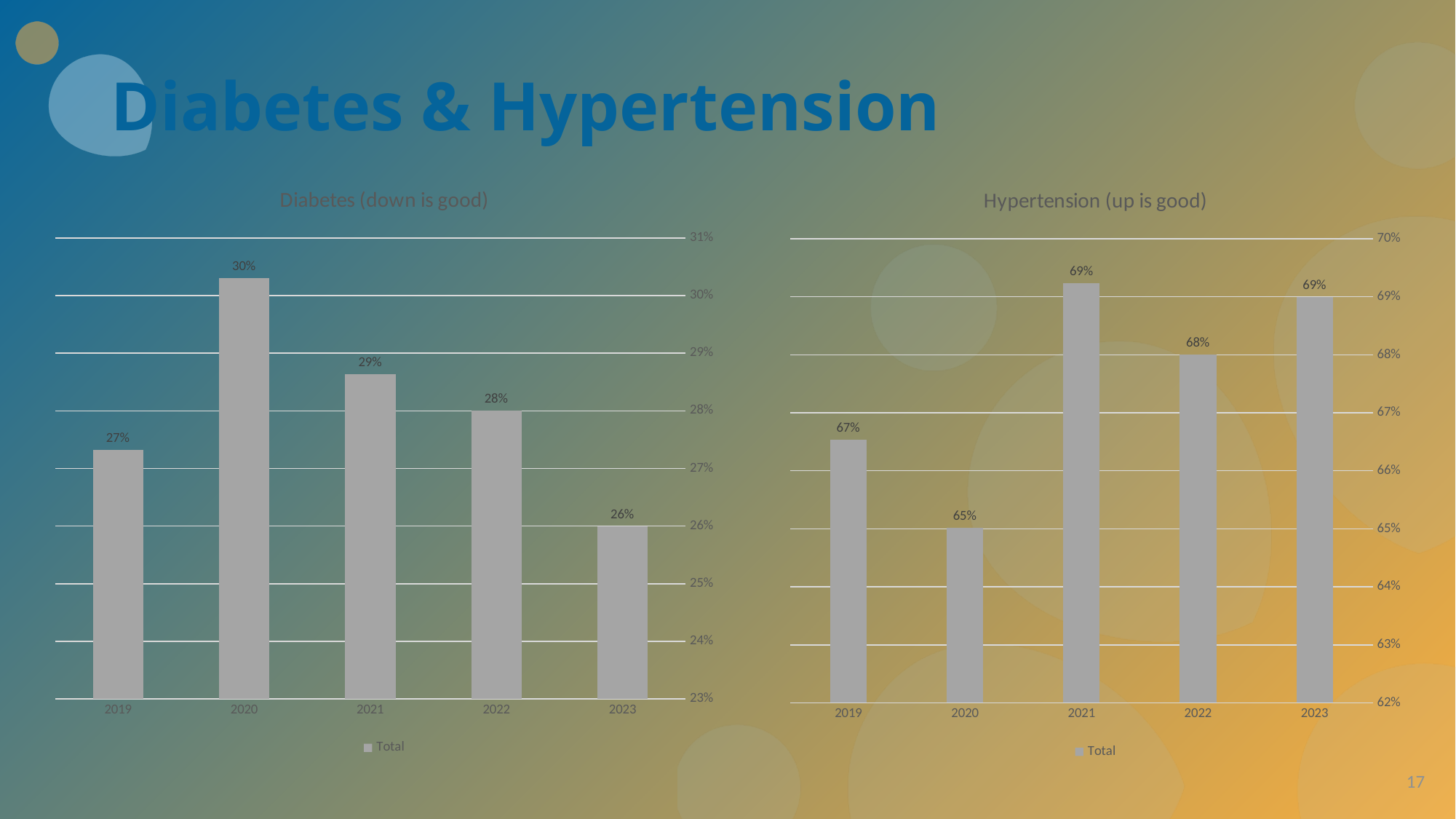
In the 'Diabetes (down is good)' chart, what is the difference between the 2020 value and the 2023 value? 4% In the 'Diabetes (down is good)' chart, which year has the lowest value? 2023 In the 'Hypertension (up is good)' chart, what is the difference between the 2021 value and the 2020 value? 4% In the 'Hypertension (up is good)' chart, which is larger, the value for 2019 or the value for 2020? 2019 In the 'Diabetes (down is good)' chart, what is the value for 2020? 30% In the 'Hypertension (up is good)' chart, what is the value for 2019? 67% In the 'Diabetes (down is good)' chart, what is the value for 2023? 26% In the 'Hypertension (up is good)' chart, which year has the lowest value? 2020 In the 'Hypertension (up is good)' chart, what is the value for 2022? 68% What kind of chart is the 'Hypertension (up is good)' chart? Bar chart In the 'Diabetes (down is good)' chart, which year has the highest value? 2020 How many years are shown on the x axis of the 'Diabetes (down is good)' chart? 5